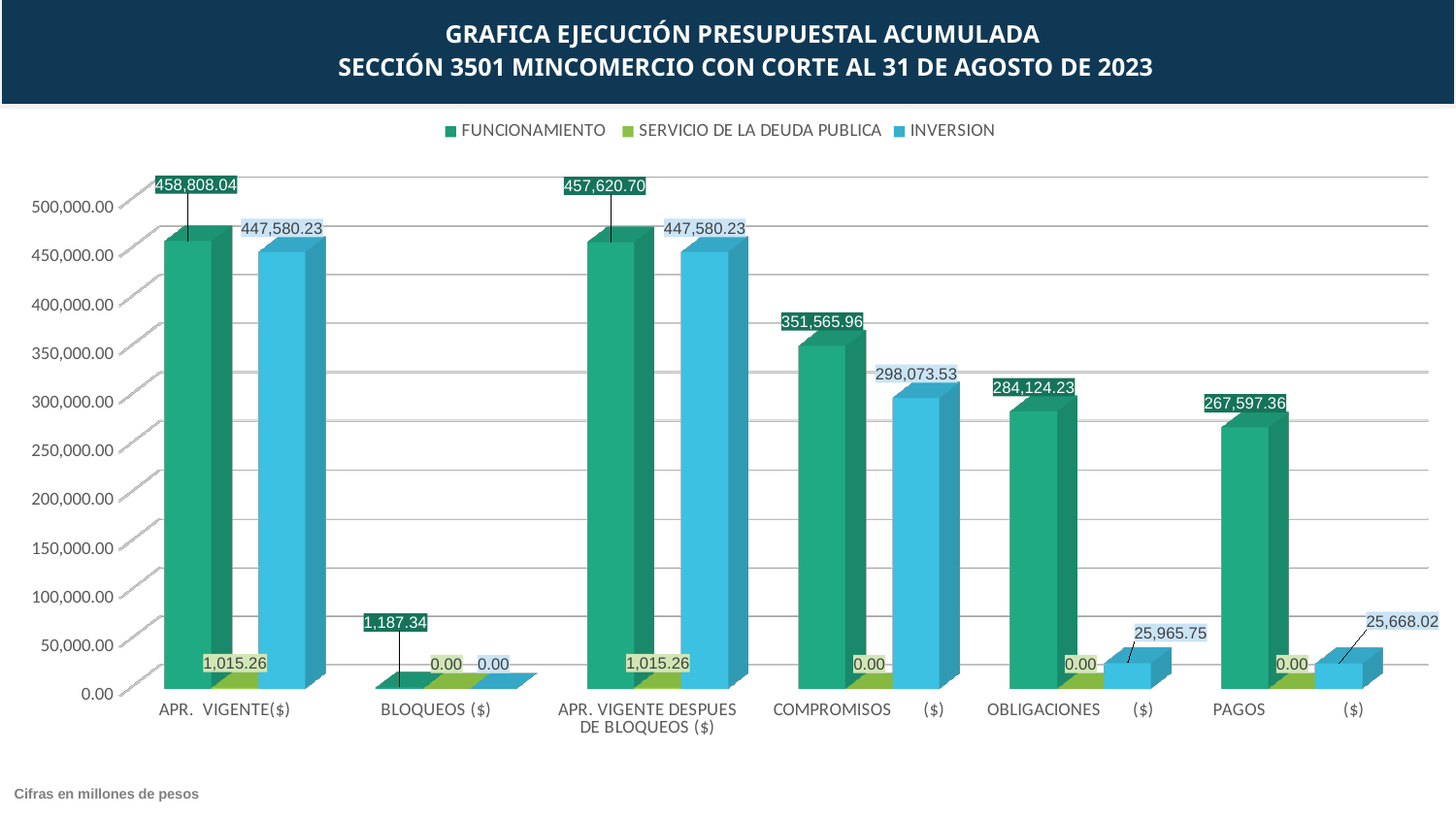
What is the INVERSION value for COMPROMISOS ($)? 298,073.53 What is the INVERSION value for PAGOS ($)? 25,668.02 Which is larger for COMPROMISOS ($): the FUNCIONAMIENTO value or the INVERSION value? FUNCIONAMIENTO Which category has the highest FUNCIONAMIENTO value? APR. VIGENTE($) How many categories are shown on the x axis? 6 What is the SERVICIO DE LA DEUDA PUBLICA value for APR. VIGENTE DESPUES DE BLOQUEOS ($)? 1,015.26 What is the FUNCIONAMIENTO value for APR. VIGENTE($)? 458,808.04 What is the difference between the FUNCIONAMIENTO values for OBLIGACIONES ($) and PAGOS ($)? 16,526.87 Which category has the lowest INVERSION value? BLOQUEOS ($) What kind of chart is shown on the slide? Bar chart How many series does the legend list? 3 What is the FUNCIONAMIENTO value for BLOQUEOS ($)? 1,187.34